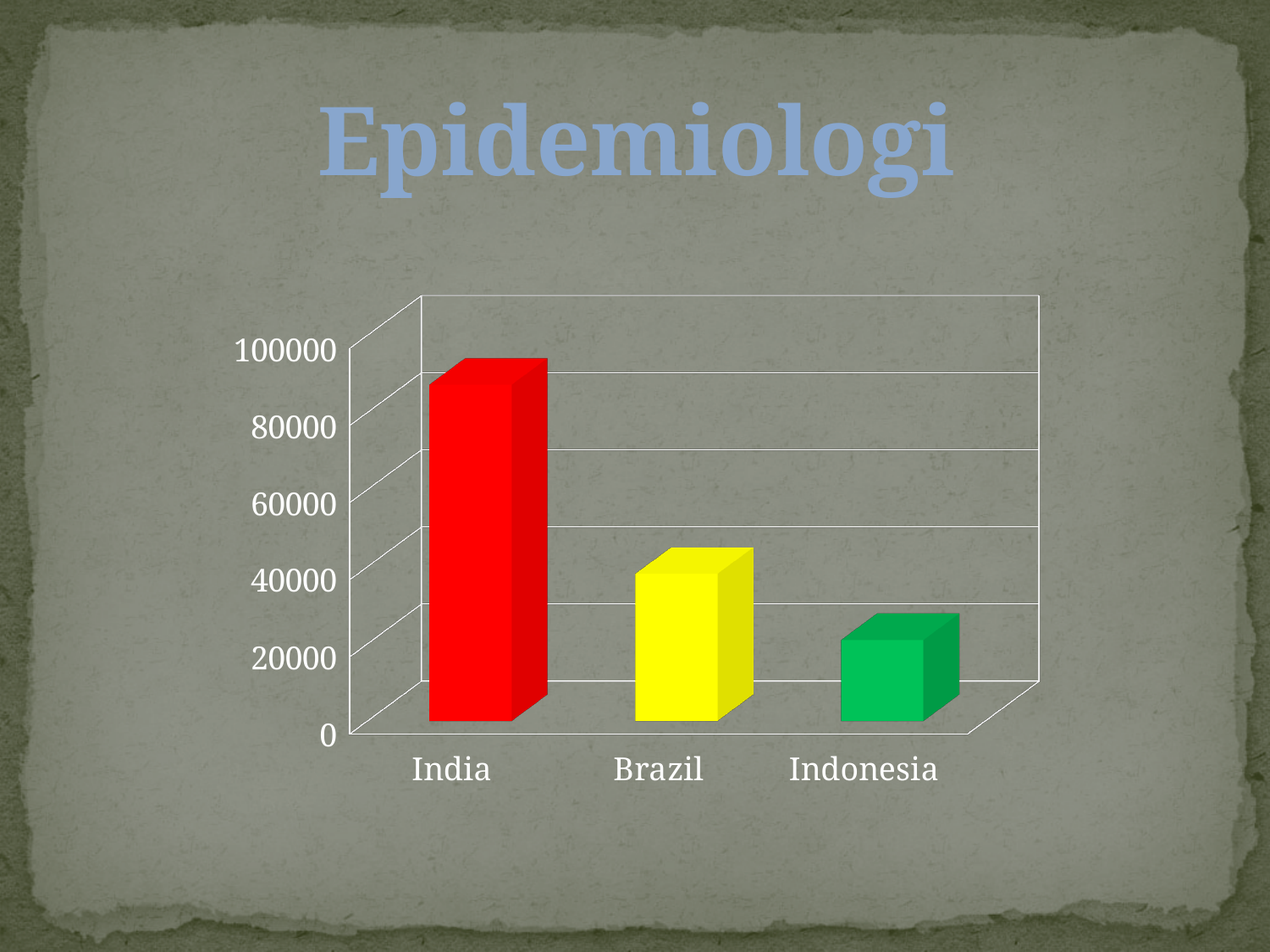
How many countries are shown on the chart? 3 Do the values rise or fall from India to Indonesia along the x axis? fall Which country has the lowest value on the chart? Indonesia Is the value for India greater or less than 80000? greater What kind of chart is shown on the slide? bar chart Which has a larger value, India or Brazil? India Which country has the highest value on the chart? India Is the value for Brazil greater or less than 60000? less Which has a larger value, Brazil or Indonesia? Brazil What colour is the bar for Brazil? yellow Is the value for Indonesia greater or less than 40000? less